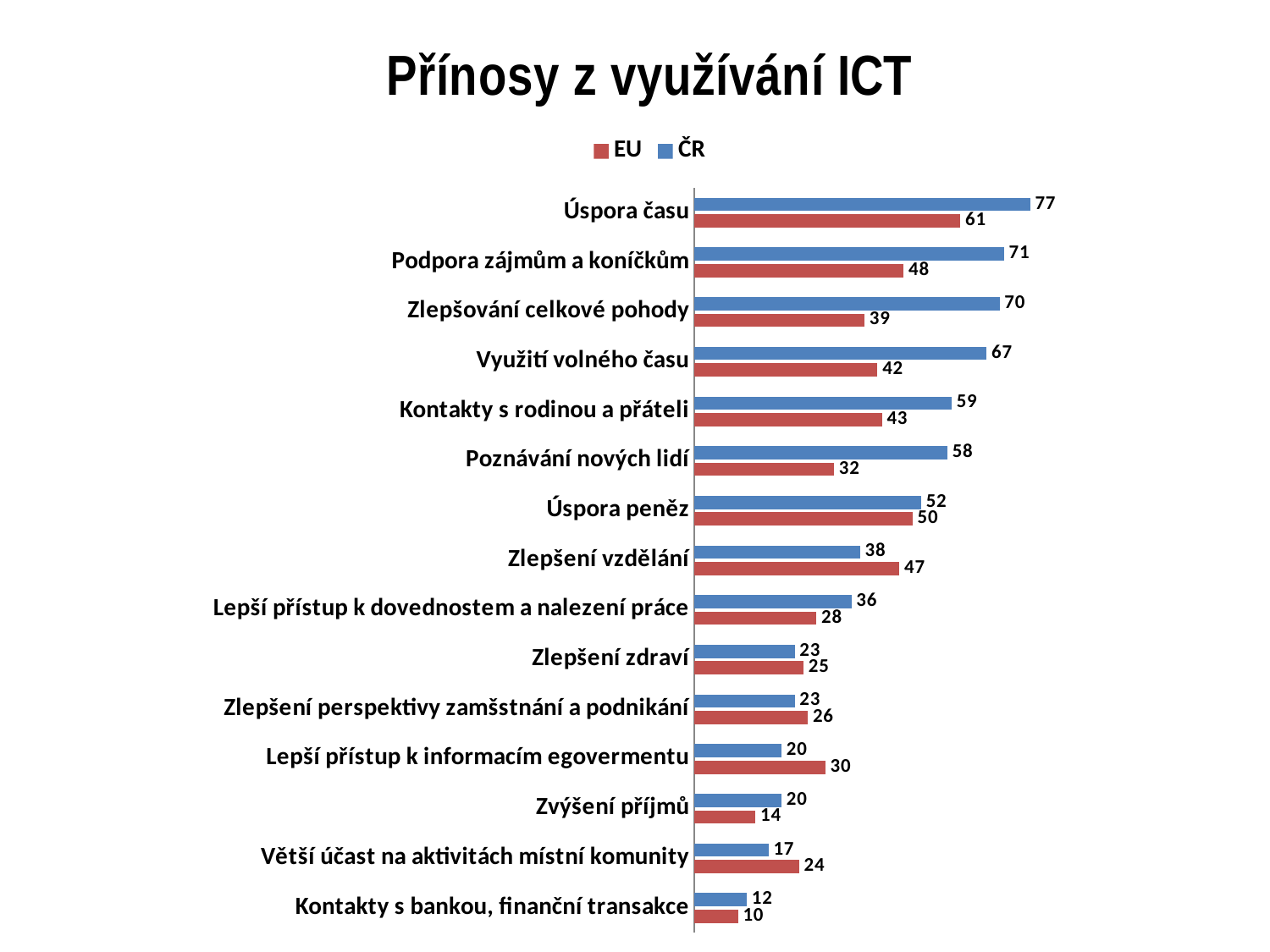
How many series does the legend list? 2 What kind of chart is shown on the slide? Bar chart How many categories are shown in the chart? 15 Which category has the highest ČR value? Úspora času Which is larger for Zlepšení vzdělání, the EU value or the ČR value? EU Which colour represents the ČR series? Blue What is the EU value for Lepší přístup k informacím egovermentu? 30 What is the difference between the ČR and EU values for Zlepšování celkové pohody? 31 What is the ČR value for Úspora času? 77 What is the EU value for Podpora zájmům a koníčkům? 48 Which category has the lowest EU value? Kontakty s bankou, finanční transakce What is the title of the chart? Přínosy z využívání ICT